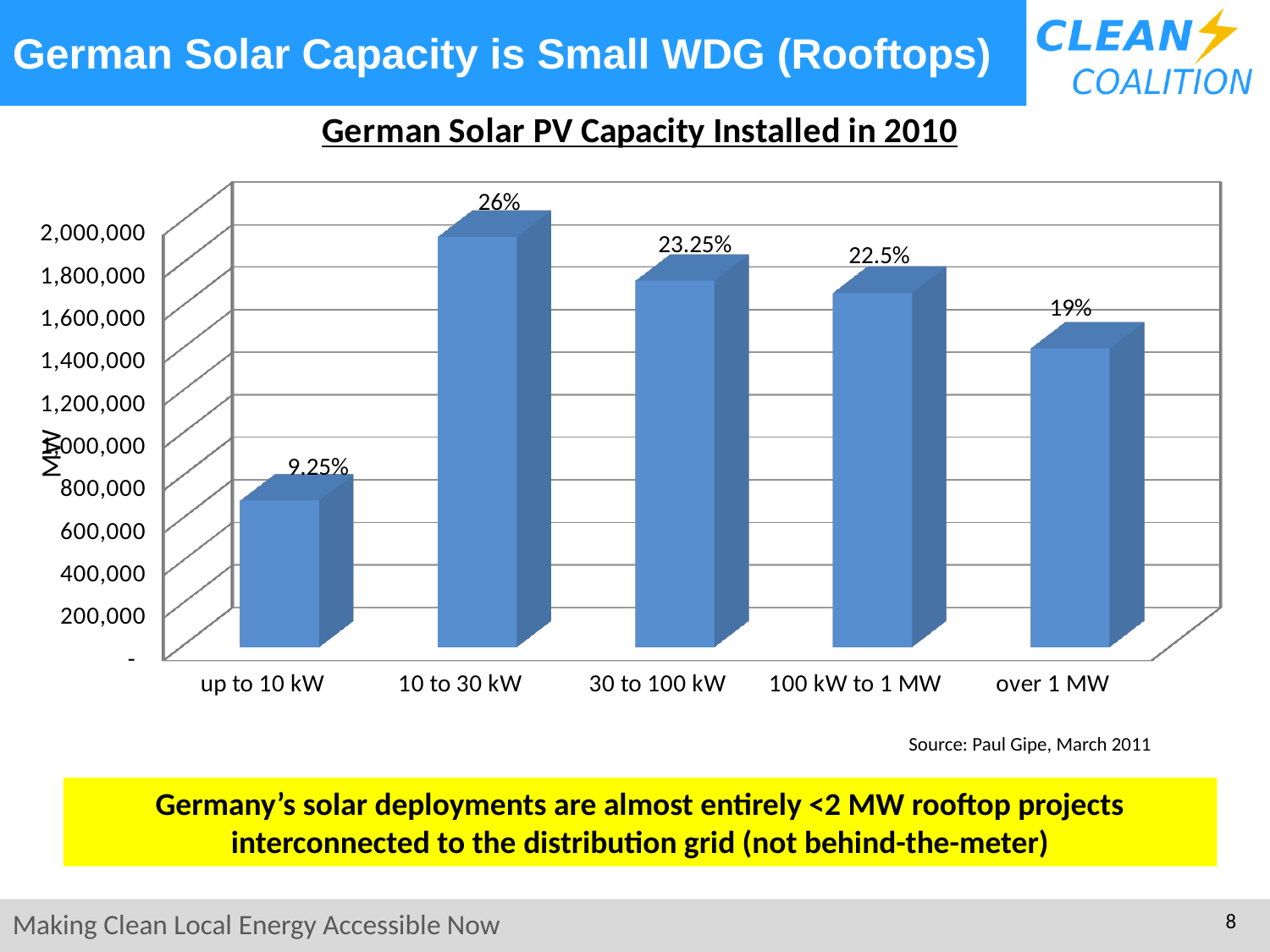
What is the difference between the percentage labels for '10 to 30 kW' and 'up to 10 kW'? 16.75% Which category has the highest installed capacity? 10 to 30 kW Which category has the lowest installed capacity? up to 10 kW What kind of chart is shown on the slide? bar chart What percentage label is shown on the bar for 'up to 10 kW'? 9.25% What percentage label is shown on the bar for '10 to 30 kW'? 26% Is the value for 'up to 10 kW' greater or less than 1,000,000 MW? less What is the title of the chart? German Solar PV Capacity Installed in 2010 What percentage label is shown on the bar for '100 kW to 1 MW'? 22.5% What unit is shown on the y axis of the chart? MW How many categories are shown on the x axis of the chart? 5 What percentage label is shown on the bar for 'over 1 MW'? 19%